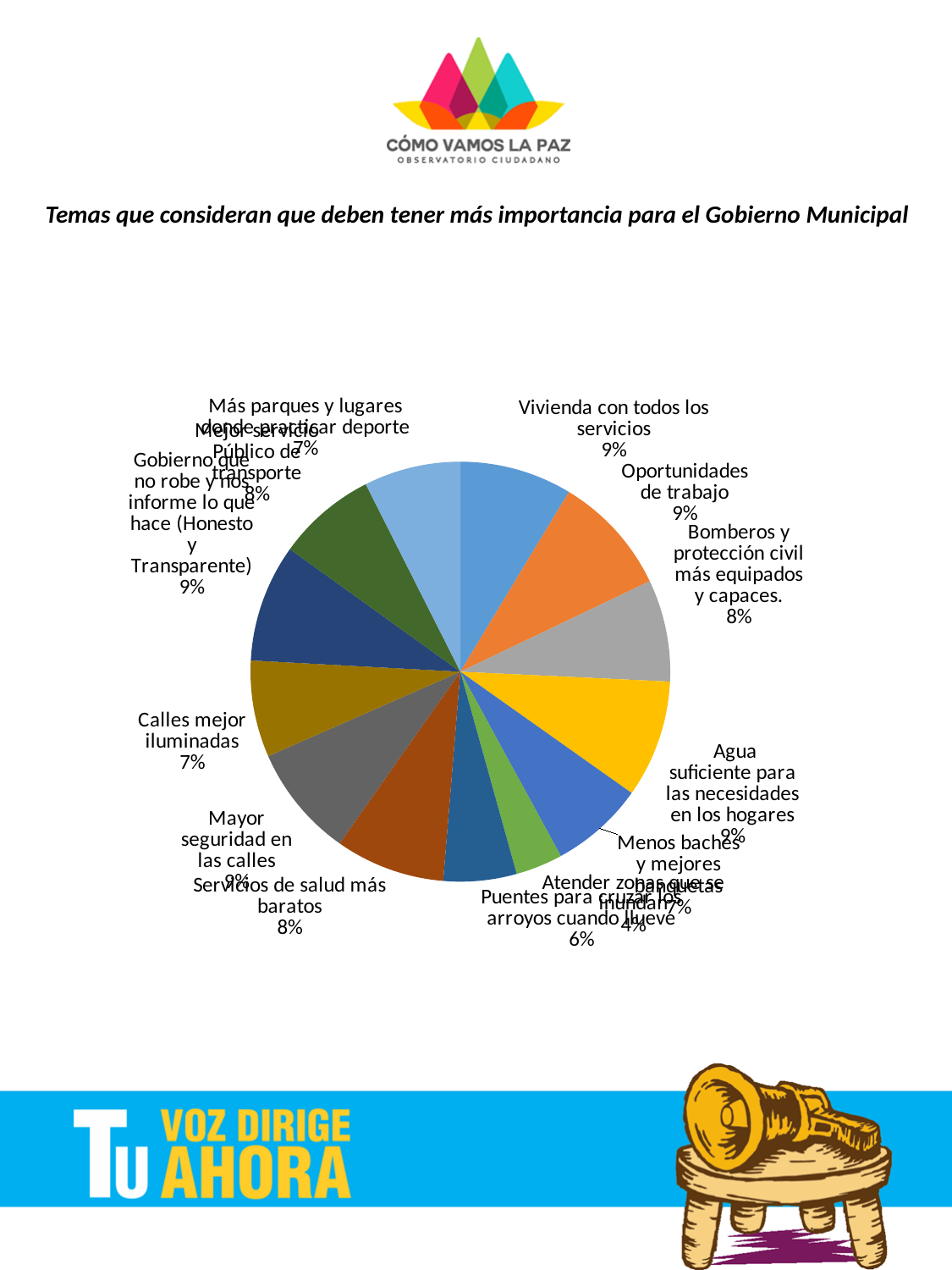
What percentage is shown for 'Gobierno que no robe y nos informe lo que hace (Honesto y Transparente)'? 9% What percentage is shown for 'Agua suficiente para las necesidades en los hogares'? 9% Which has a larger share: 'Calles mejor iluminadas' or 'Puentes para cruzar los arroyos cuando llueve'? Calles mejor iluminadas What is the title of the chart? Temas que consideran que deben tener más importancia para el Gobierno Municipal What percentage is shown for 'Servicios de salud más baratos'? 8% What percentage is shown for 'Puentes para cruzar los arroyos cuando llueve'? 6% What percentage is shown for 'Bomberos y protección civil más equipados y capaces'? 8% What share of the pie is 'Vivienda con todos los servicios'? 9% What kind of chart is shown on the slide? pie chart What percentage is shown for 'Calles mejor iluminadas'? 7% What is the difference in percentage points between 'Mayor seguridad en las calles' and 'Calles mejor iluminadas'? 2 percentage points What percentage is shown for 'Oportunidades de trabajo'? 9%